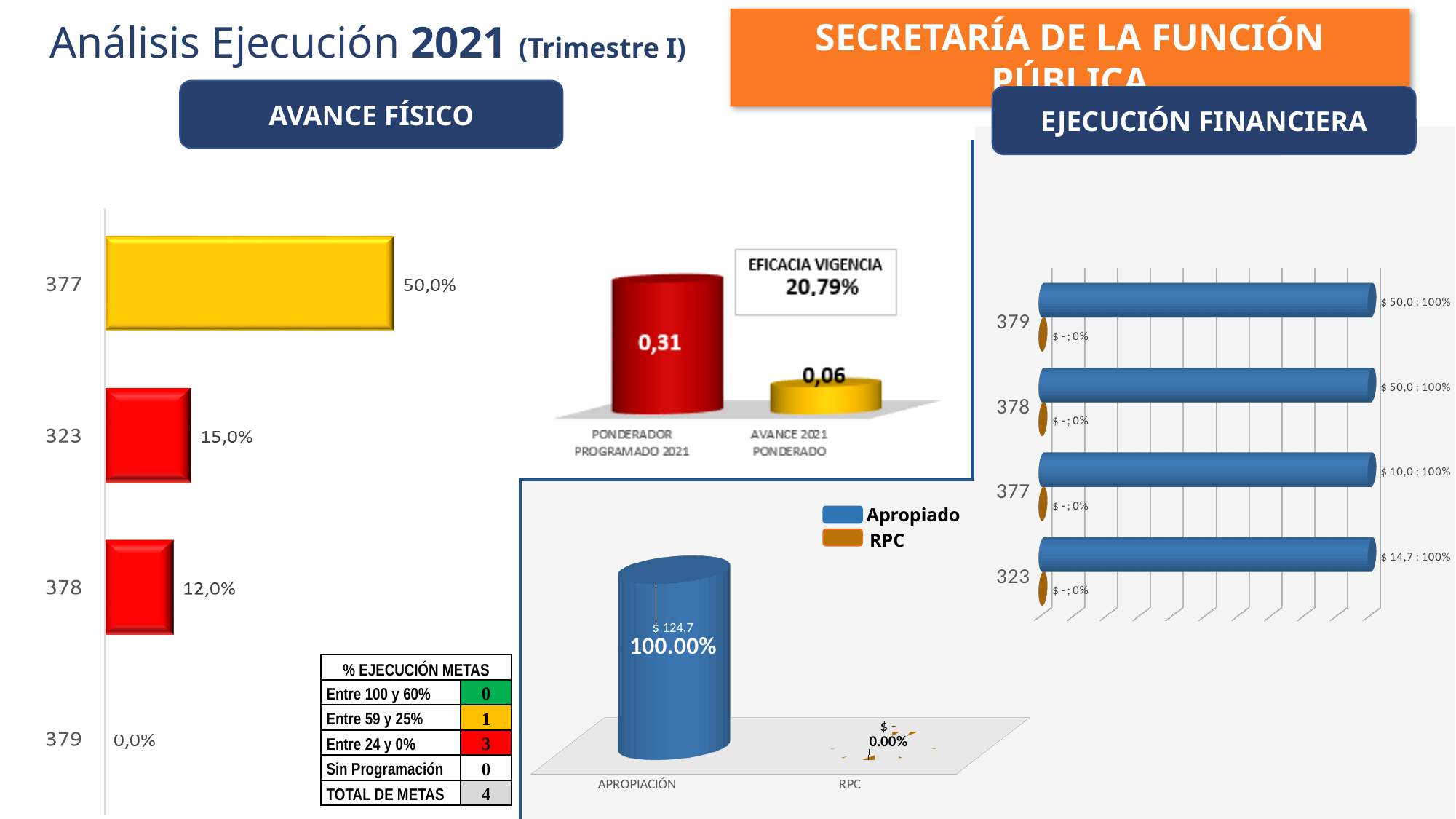
In the Avance Físico bar chart on the left, what is the value for category 377? 50,0% In the Avance Físico bar chart on the left, what is the value for category 378? 12,0% In the cylinder chart in the top middle, which is larger: Ponderador Programado 2021 or Avance 2021 Ponderado? Ponderador Programado 2021 In the Avance Físico bar chart on the left, which category has the highest value? 377 In the Avance Físico bar chart on the left, how many categories are shown? 4 In the Avance Físico bar chart on the left, which category has the lowest value? 379 In the Ejecución Financiera bar chart on the right, what is the Apropiado value for category 323? $ 14,7 In the cylinder chart in the top middle, what is the value for Ponderador Programado 2021? 0,31 In the Avance Físico bar chart on the left, what is the difference between the values for 323 and 378? 3,0% In the cylinder chart in the top middle, what Eficacia Vigencia value is shown? 20,79% In the bottom-middle chart, what value is shown for Apropiación? $ 124,7